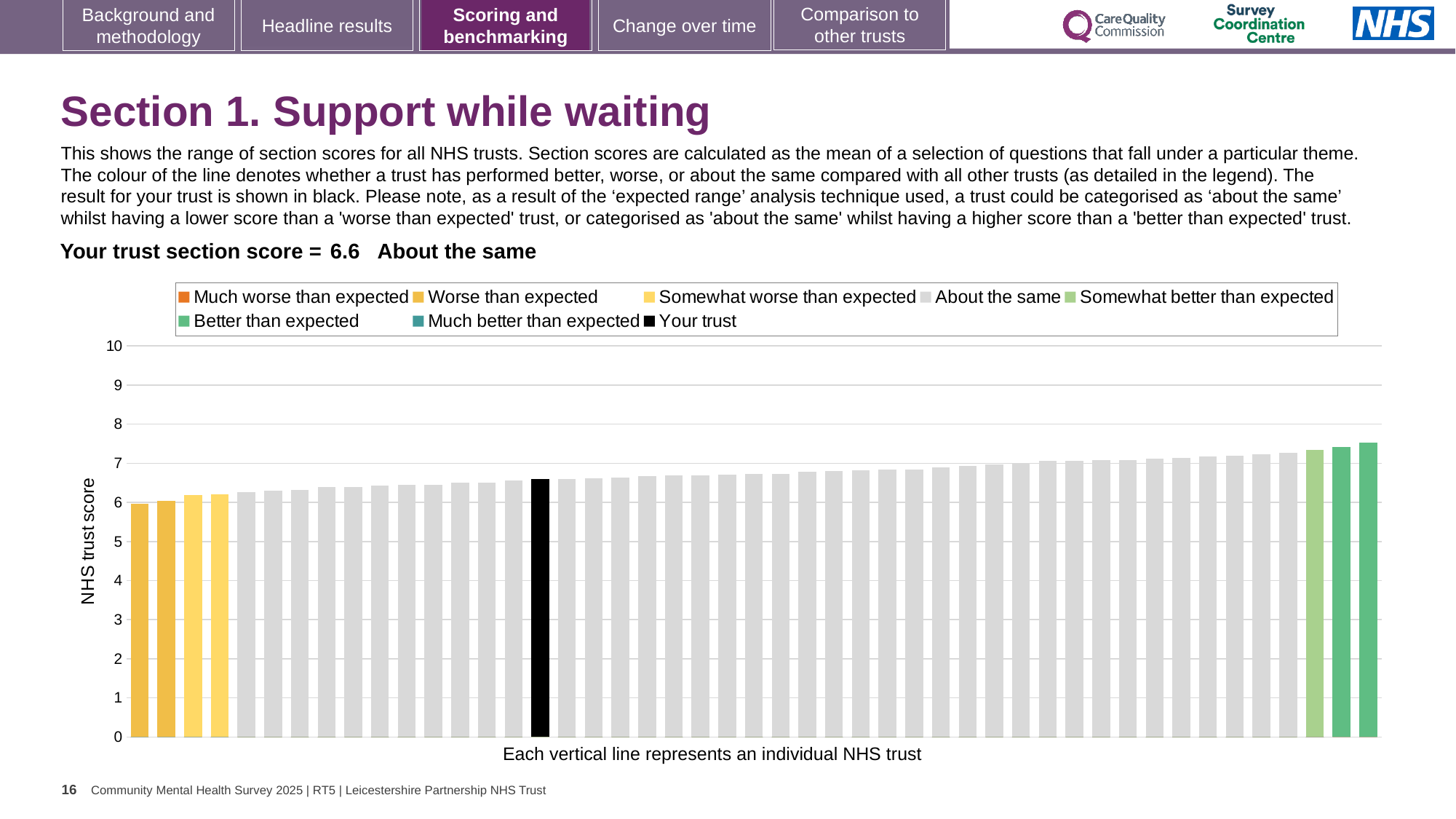
How many bars are coloured yellow (worse than expected or somewhat worse than expected)? 4 Which category is your trust placed in for this section? About the same What colour is used for the bar representing your trust? black How many entries does the chart legend list? 8 What is the section score for your trust shown on the slide? 6.6 Is the value for the rightmost bar greater or less than 7? greater What is the label on the vertical axis of the chart? NHS trust score How many bars are coloured green (better than expected or somewhat better than expected)? 3 Do the bar values rise or fall from left to right along the x axis? rise Is the value for the leftmost bar greater or less than 5? greater Is the value for your trust (the black bar) greater or less than 7? less What kind of chart is shown on the slide? bar chart